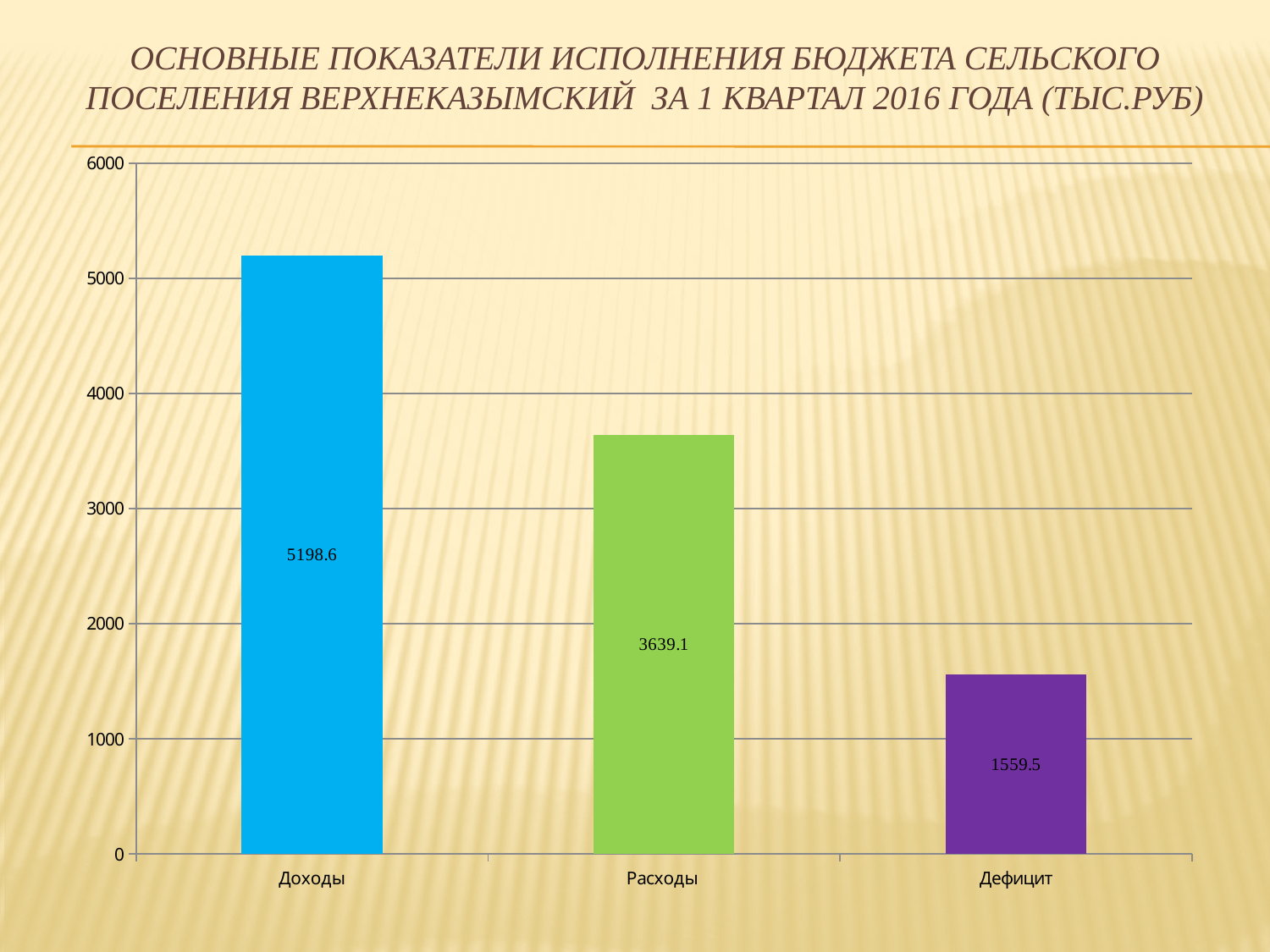
What is the value for Дефицит? 1559.5 Which category has the highest value? Доходы Is the value for Расходы greater or less than 4000? less What is the value for Доходы? 5198.6 What is the difference between Расходы and Дефицит? 2079.6 What is the difference between Доходы and Расходы? 1559.5 What kind of chart is shown on the slide? bar chart Which is larger, Расходы or Дефицит? Расходы What is the value for Расходы? 3639.1 How many categories are shown on the chart? 3 Which category has the lowest value? Дефицит What colour is the bar for Дефицит? purple